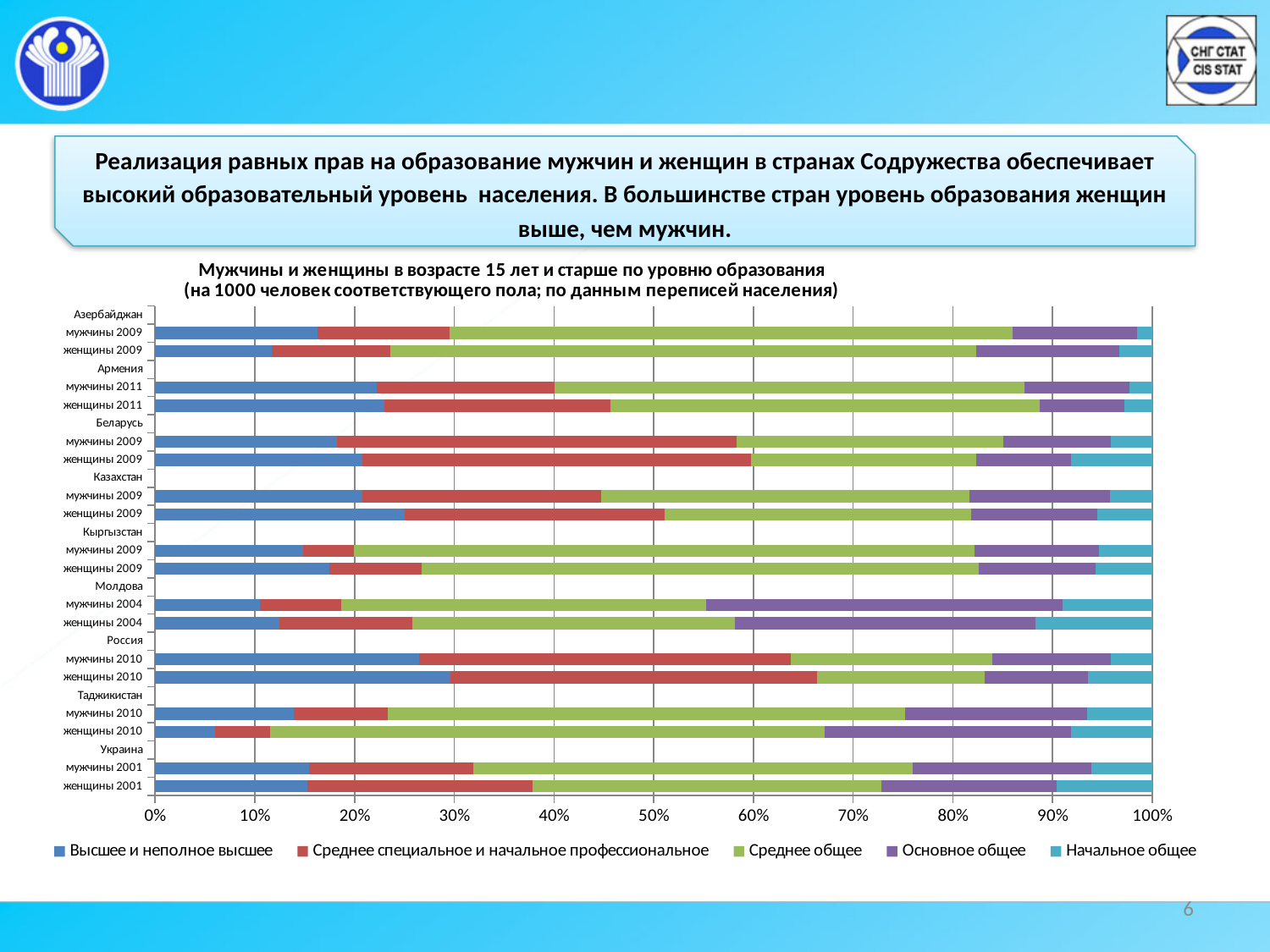
What is the highest value shown on the horizontal axis of the chart? 100% Is the share of 'Высшее и неполное высшее' for 'мужчины 2009' under Азербайджан greater or less than 10%? greater How many series does the legend of the chart list? 5 How many bars (men and women rows) are plotted in the chart? 18 How many countries are listed as group headings on the vertical axis of the chart? 9 Is the share of 'Высшее и неполное высшее' for 'женщины 2010' under Таджикистан greater or less than 10%? less What kind of chart is shown on the slide? Stacked bar chart Which bar has the smallest 'Высшее и неполное высшее' segment? женщины 2010 (Таджикистан) Which has the larger 'Высшее и неполное высшее' segment: 'женщины 2010' under Россия or 'женщины 2010' under Таджикистан? женщины 2010 under Россия Is the share of 'Высшее и неполное высшее' for 'женщины 2010' under Россия greater or less than 20%? greater What do the segments of each stacked bar in the chart add up to? 100% Which series is listed first in the chart legend? Высшее и неполное высшее